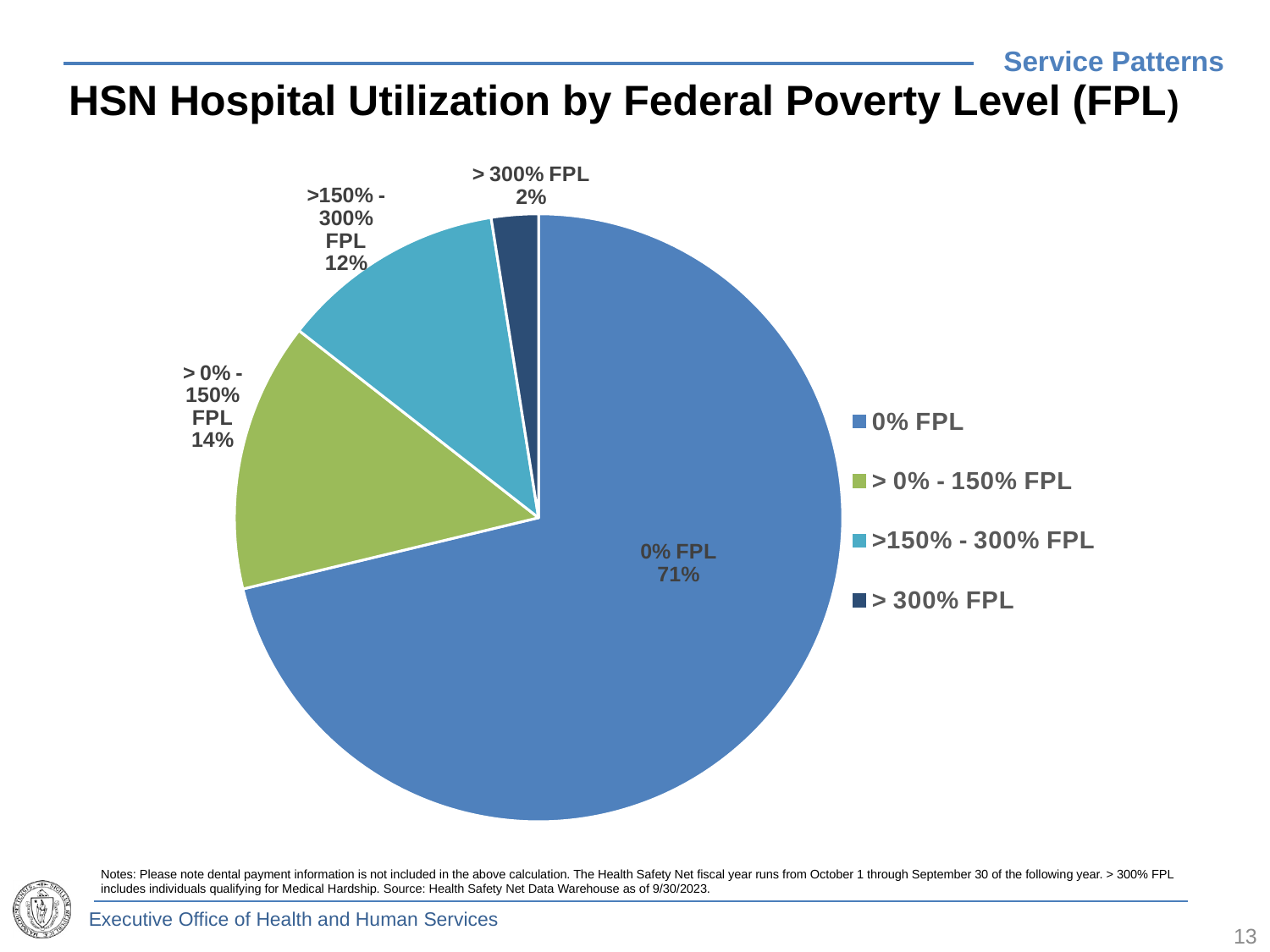
What is the title of the chart on the slide? HSN Hospital Utilization by Federal Poverty Level (FPL) What kind of chart is shown on the slide? Pie chart What is the difference in percentage points between the 0% FPL share and the > 0% - 150% FPL share? 57 Which is larger, the share for > 0% - 150% FPL or the share for >150% - 300% FPL? > 0% - 150% FPL What share of HSN hospital utilization is for the 0% FPL group? 71% What share of HSN hospital utilization is for the > 300% FPL group? 2% How many FPL groups are shown in the pie chart? 4 What share of HSN hospital utilization is for the > 0% - 150% FPL group? 14% What is the difference in percentage points between the >150% - 300% FPL share and the > 300% FPL share? 10 Which FPL group has the smallest share of HSN hospital utilization? > 300% FPL Which FPL group has the largest share of HSN hospital utilization? 0% FPL